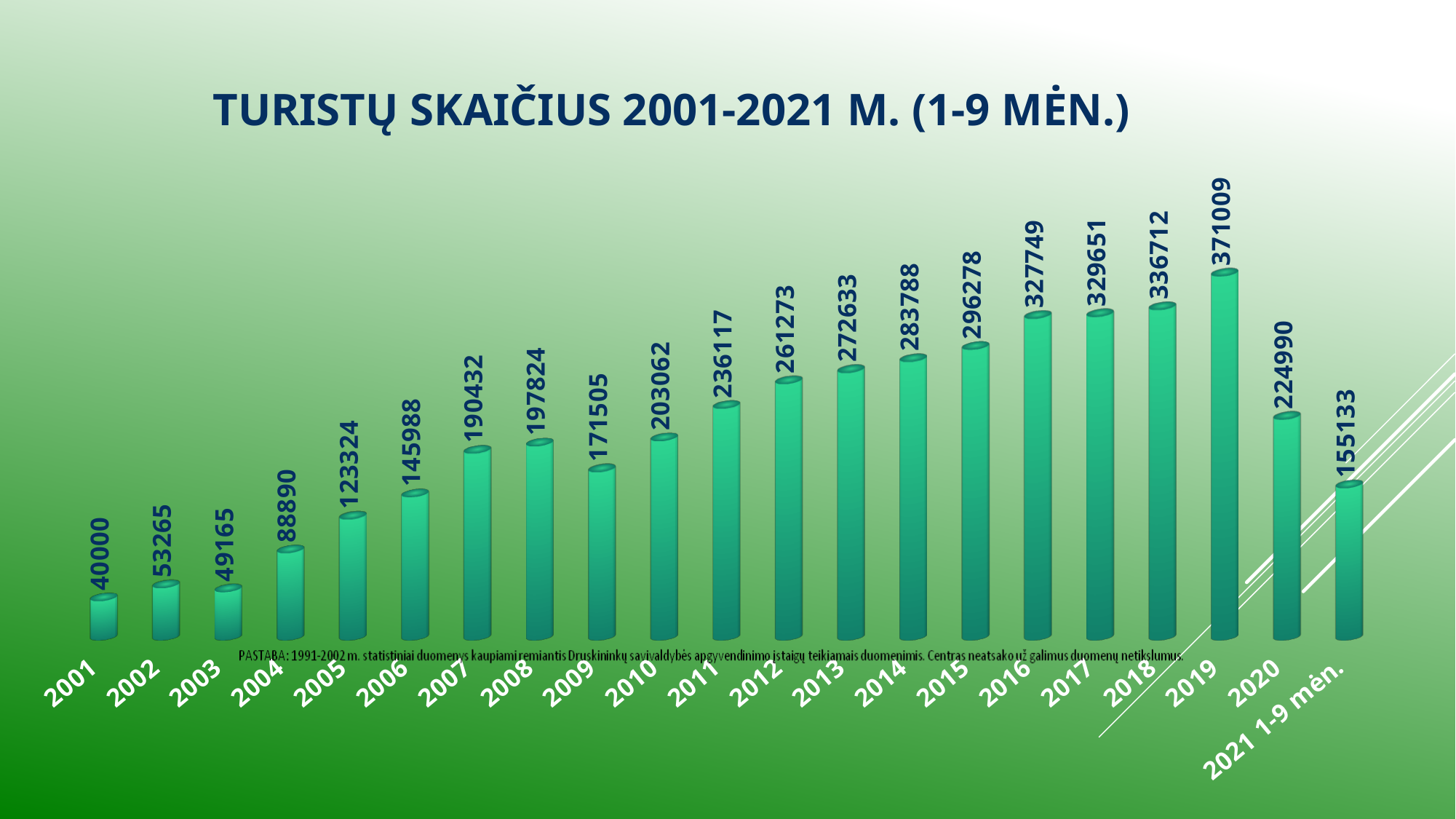
Which is larger, the value for 2008 or for 2009? 2008 What is the title of the chart? TURISTŲ SKAIČIUS 2001-2021 M. (1-9 MĖN.) Which is larger, the value for 2002 or for 2003? 2002 What is the number of tourists shown for 2010? 203062 What kind of chart is this? Bar chart What value is shown for 2021 1-9 mėn.? 155133 Which year has the lowest number of tourists? 2001 What is the value for 2004? 88890 By how much did the value fall from 2020 to 2021 1-9 mėn.? 69857 Which year has the highest number of tourists? 2019 What is the difference between the values for 2019 and 2001? 331009 How many categories (years) are shown on the x axis? 21